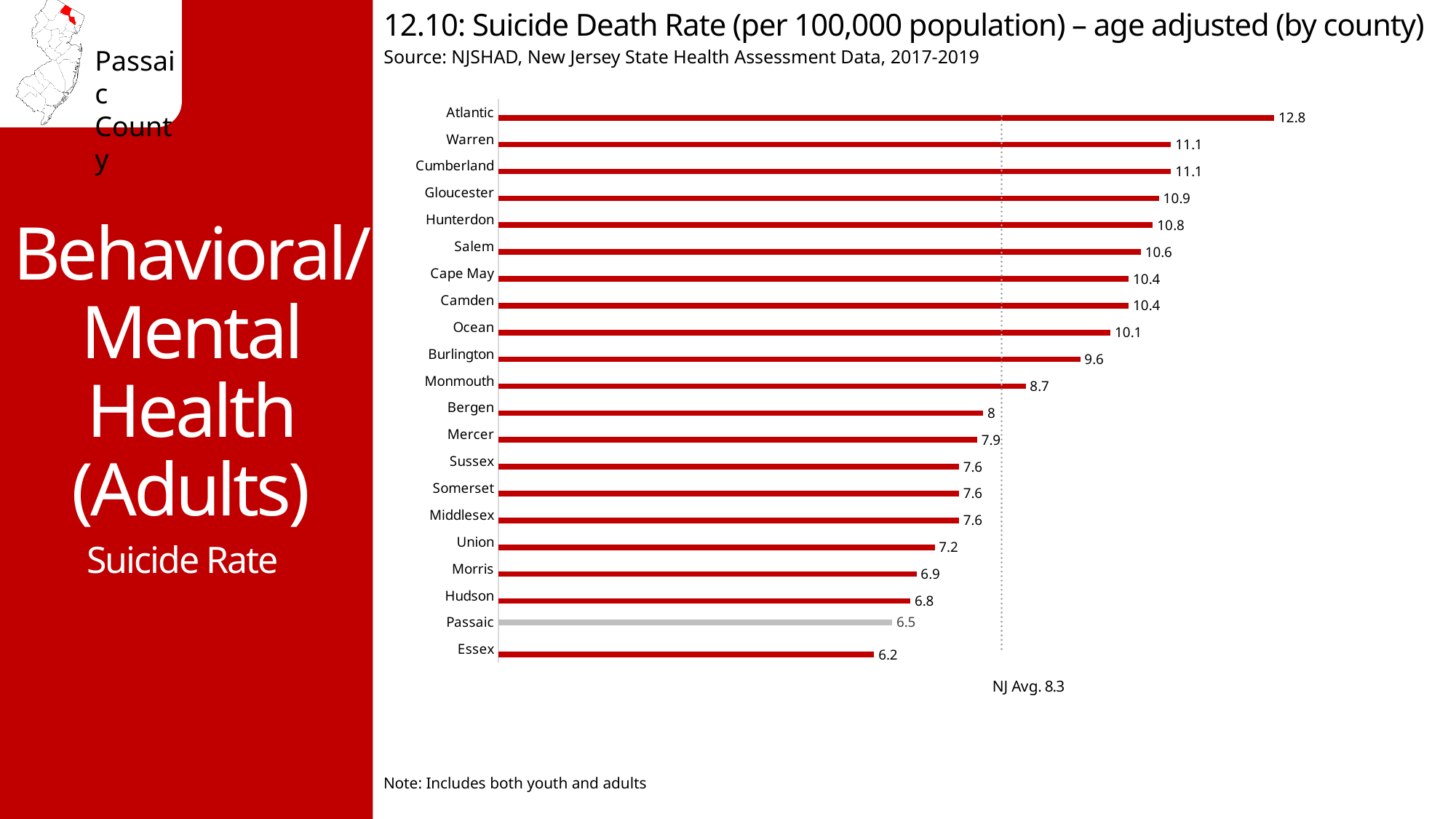
What is the suicide death rate for Passaic county? 6.5 Which county has a higher suicide death rate, Gloucester or Ocean? Gloucester Which county has the highest suicide death rate? Atlantic Which county has a higher suicide death rate, Bergen or Union? Bergen Which county has the lowest suicide death rate? Essex What is the suicide death rate for Monmouth county? 8.7 What is the NJ average suicide death rate marked on the chart? 8.3 What is the difference between the suicide death rates of Passaic and Hudson counties? 0.3 How many counties are shown in the chart? 21 What is the suicide death rate for Atlantic county? 12.8 What is the difference between the suicide death rates of Atlantic and Essex counties? 6.6 What type of chart is shown on the slide? Bar chart